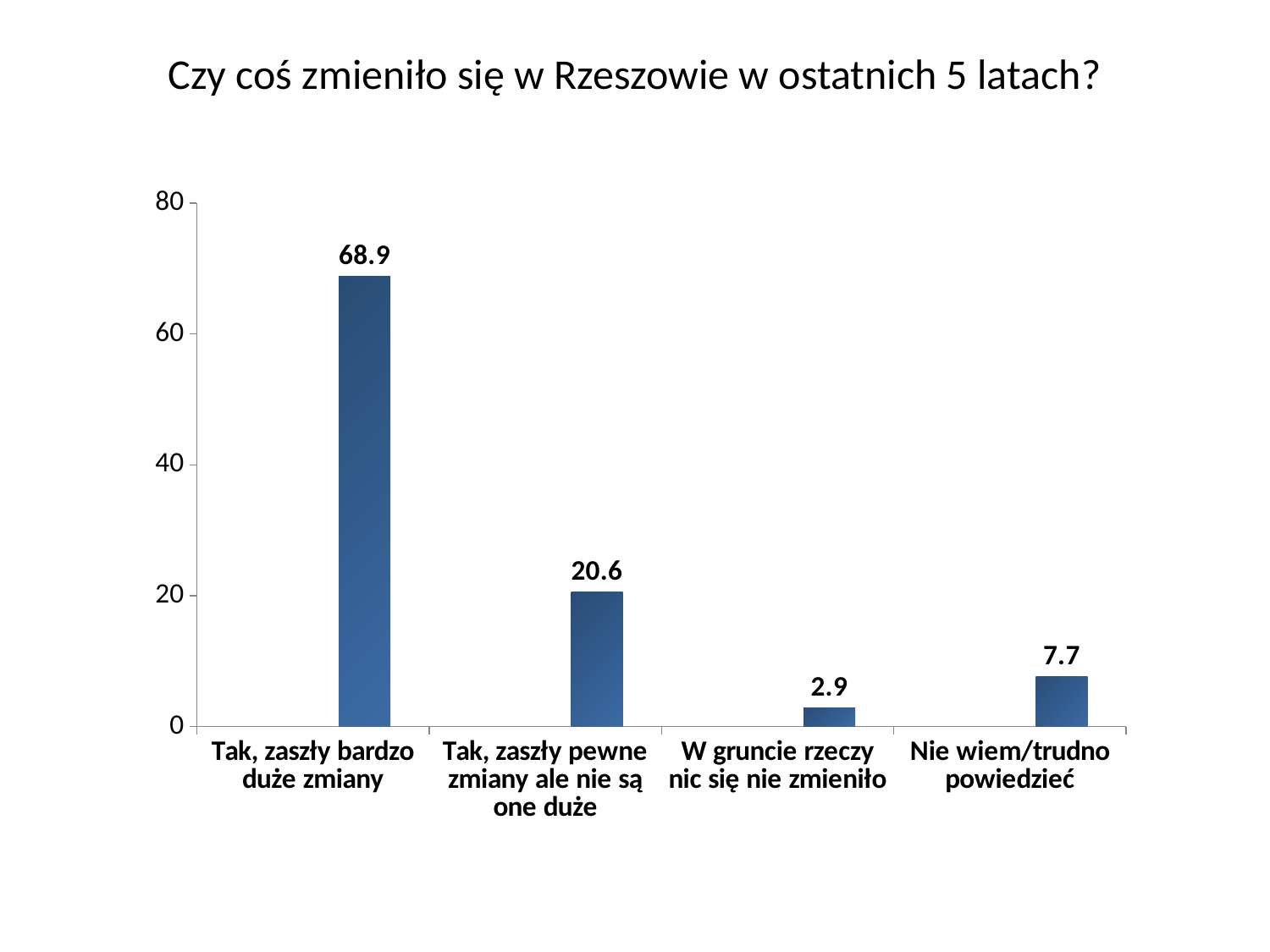
What kind of chart is shown on the slide? bar chart What is the value for "Nie wiem/trudno powiedzieć"? 7.7 Which is larger: the value for "Nie wiem/trudno powiedzieć" or the value for "W gruncie rzeczy nic się nie zmieniło"? Nie wiem/trudno powiedzieć What is the value for "Tak, zaszły bardzo duże zmiany"? 68.9 Which category has the highest value? Tak, zaszły bardzo duże zmiany Which category has the lowest value? W gruncie rzeczy nic się nie zmieniło How many categories are shown on the chart? 4 What is the difference between the values for "Tak, zaszły bardzo duże zmiany" and "Tak, zaszły pewne zmiany ale nie są one duże"? 48.3 What is the value for "Tak, zaszły pewne zmiany ale nie są one duże"? 20.6 What is the title of the chart? Czy coś zmieniło się w Rzeszowie w ostatnich 5 latach? Is the value for "Tak, zaszły pewne zmiany ale nie są one duże" greater or less than 40? less What is the value for "W gruncie rzeczy nic się nie zmieniło"? 2.9